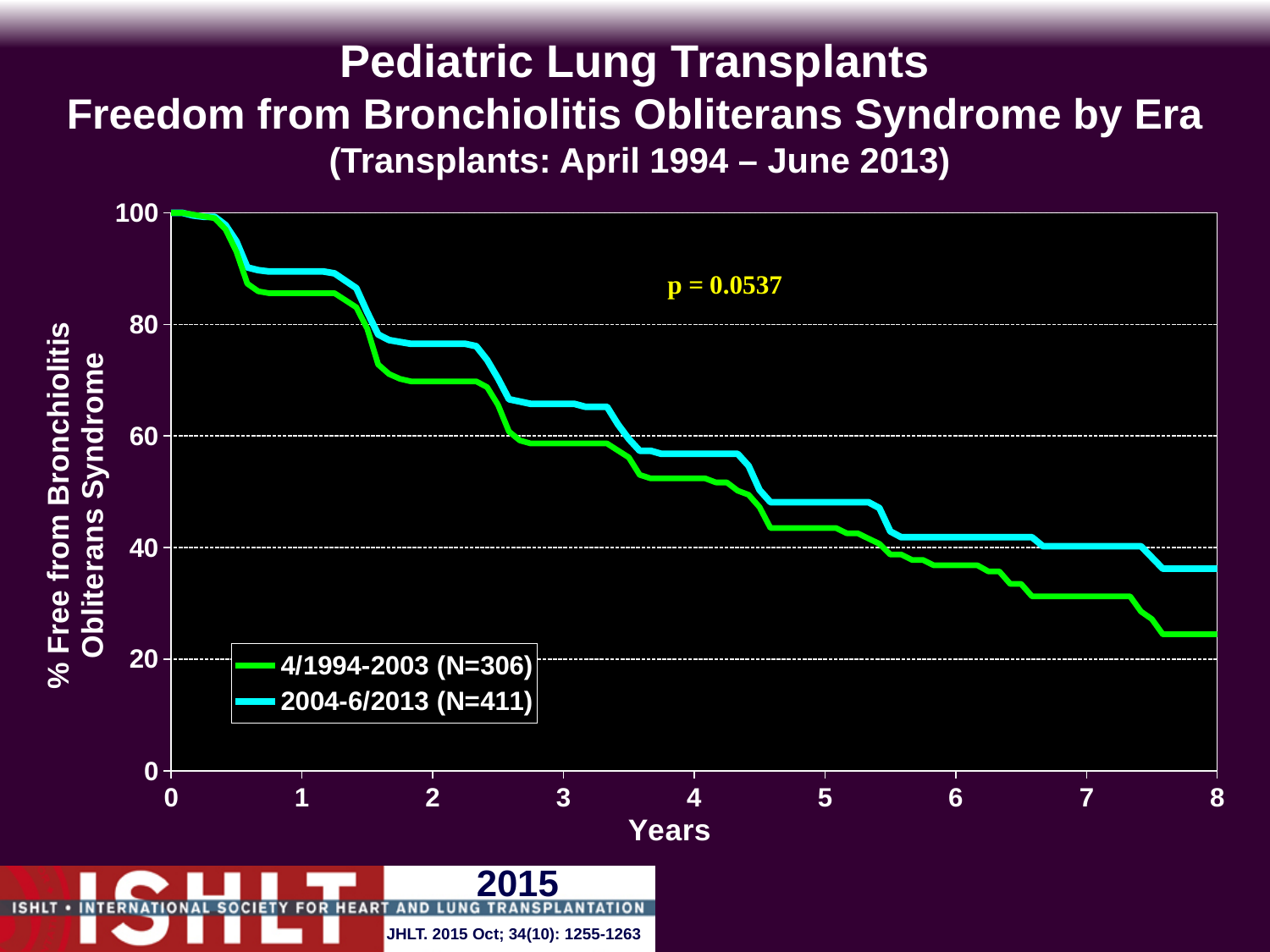
At 8 years, which era has the higher % free from bronchiolitis obliterans syndrome, 4/1994-2003 or 2004-6/2013? 2004-6/2013 Is the value for the 2004-6/2013 series at 4 years greater or less than 60? less Is the value for the 2004-6/2013 series at 8 years greater or less than 40? less Do the values for the 4/1994-2003 series rise or fall as years increase? fall Is the value for the 4/1994-2003 series at 1 year greater or less than 80? greater What kind of chart is shown on the slide? line chart What is the N for the 2004-6/2013 era shown in the legend? 411 What p-value is printed on the chart? p = 0.0537 How many series does the legend list? 2 At 2 years, which era has the higher % free from bronchiolitis obliterans syndrome, 4/1994-2003 or 2004-6/2013? 2004-6/2013